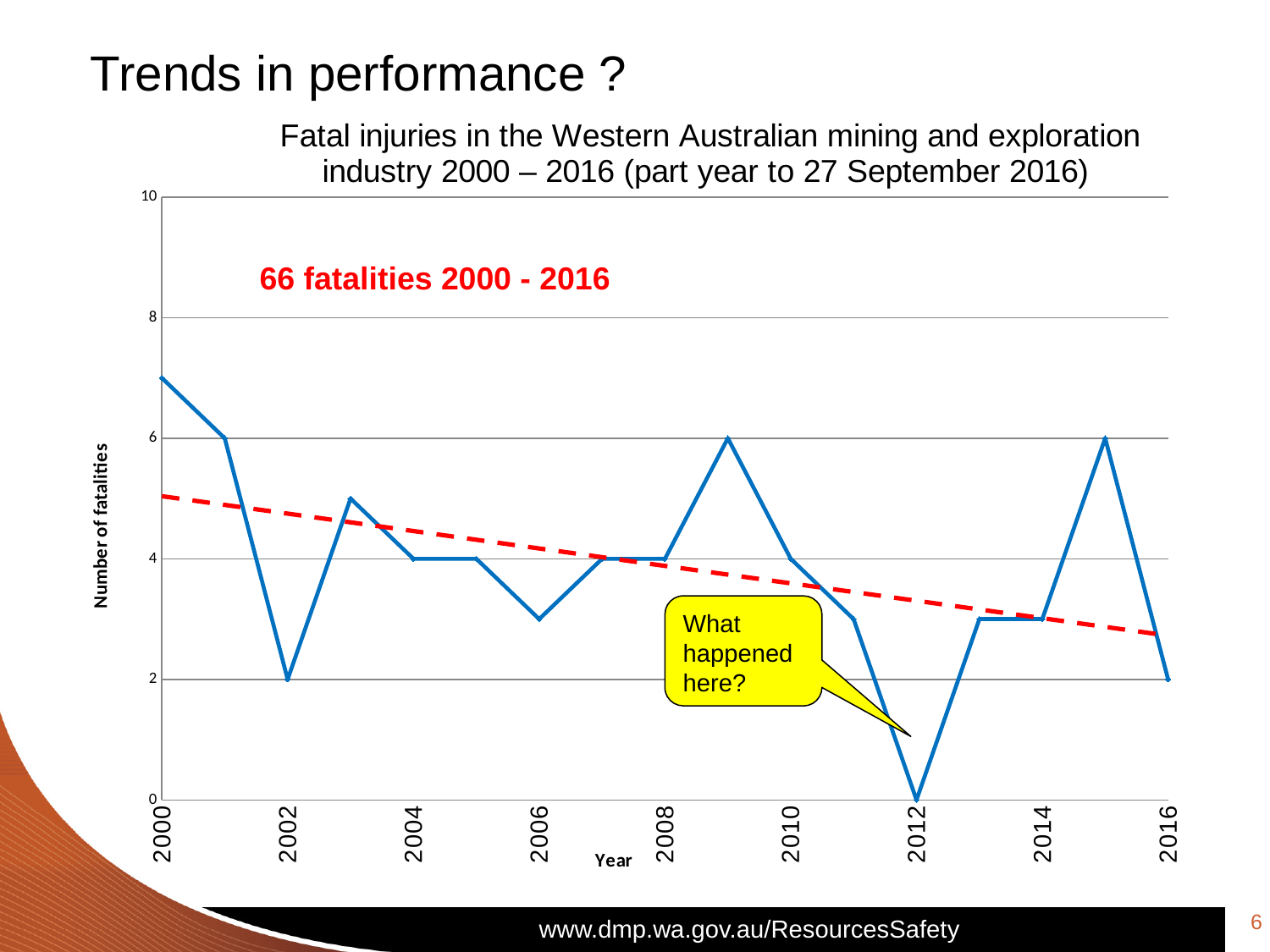
According to the dashed trend line, do fatalities rise or fall from 2000 to 2016? fall What is the number of fatalities in 2016? 2 What is the number of fatalities in 2009? 6 What is the number of fatalities in 2002? 2 Which year had more fatalities, 2015 or 2016? 2015 What is the difference between the number of fatalities in 2001 and in 2002? 4 What kind of chart is shown on the slide? line chart Which year has the highest number of fatalities? 2000 What is the number of fatalities in 2012? 0 Is the number of fatalities in 2000 greater or less than 6? greater Is the number of fatalities in 2006 greater or less than 4? less Which year has the lowest number of fatalities? 2012